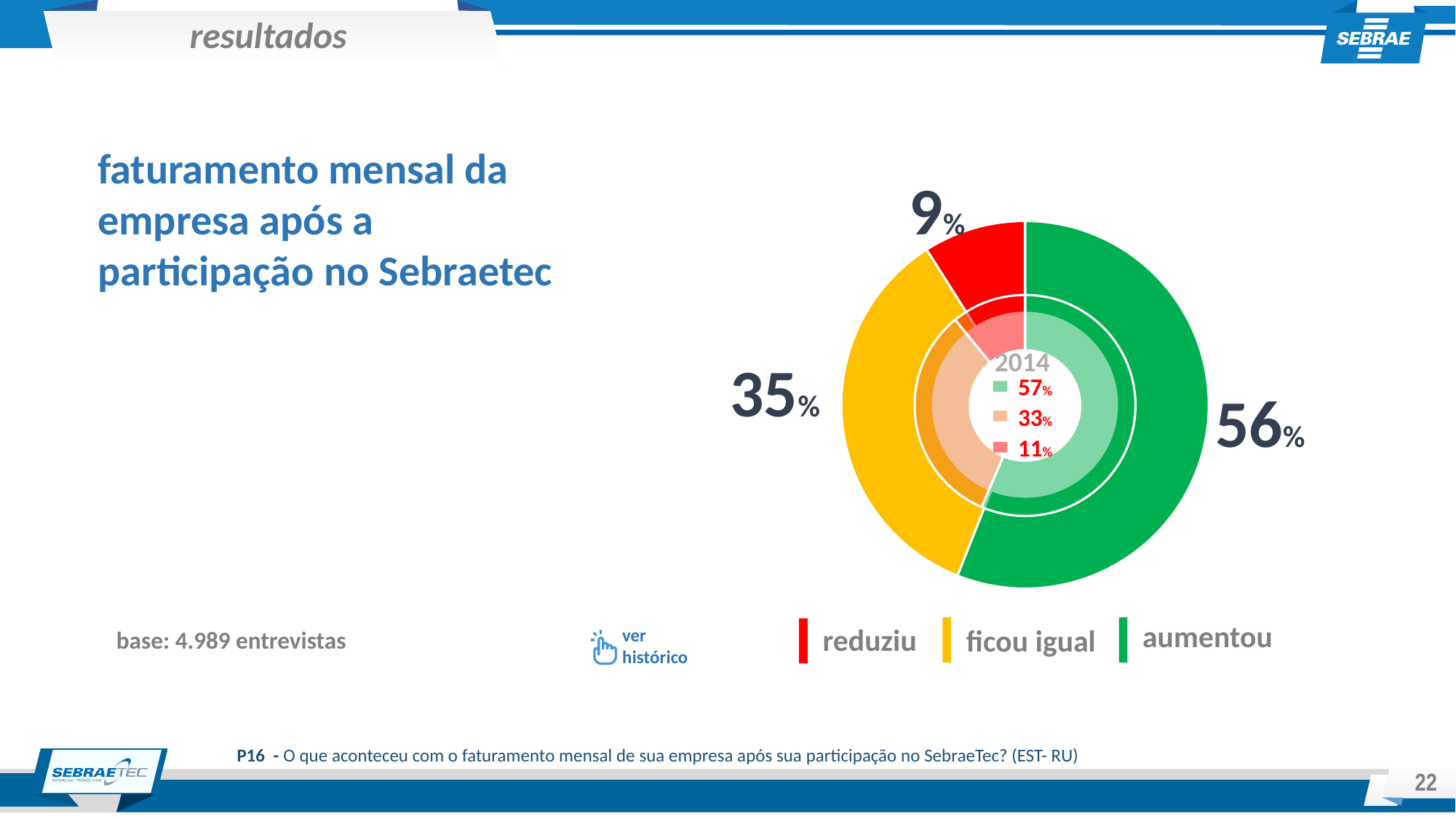
In the inner 2014 ring, what was the share for 'reduziu'? 11% What percentage of respondents said their monthly revenue increased (aumentou) after participating in Sebraetec? 56% Which colour represents 'reduziu' in the chart legend? Red Which category has the smallest share in the outer ring of the chart? reduziu In the inner 2014 ring, what was the share for 'aumentou'? 57% Which is larger in the outer ring: 'ficou igual' or 'reduziu'? ficou igual What is the difference in percentage points between 'aumentou' and 'ficou igual' in the outer ring? 21 What percentage of respondents said their monthly revenue decreased (reduziu)? 9% Which category has the largest share in the outer ring of the chart? aumentou How many categories does the legend of the chart list? 3 What percentage of respondents said their monthly revenue stayed the same (ficou igual)? 35% What kind of chart is shown on the slide? Donut (pie) chart